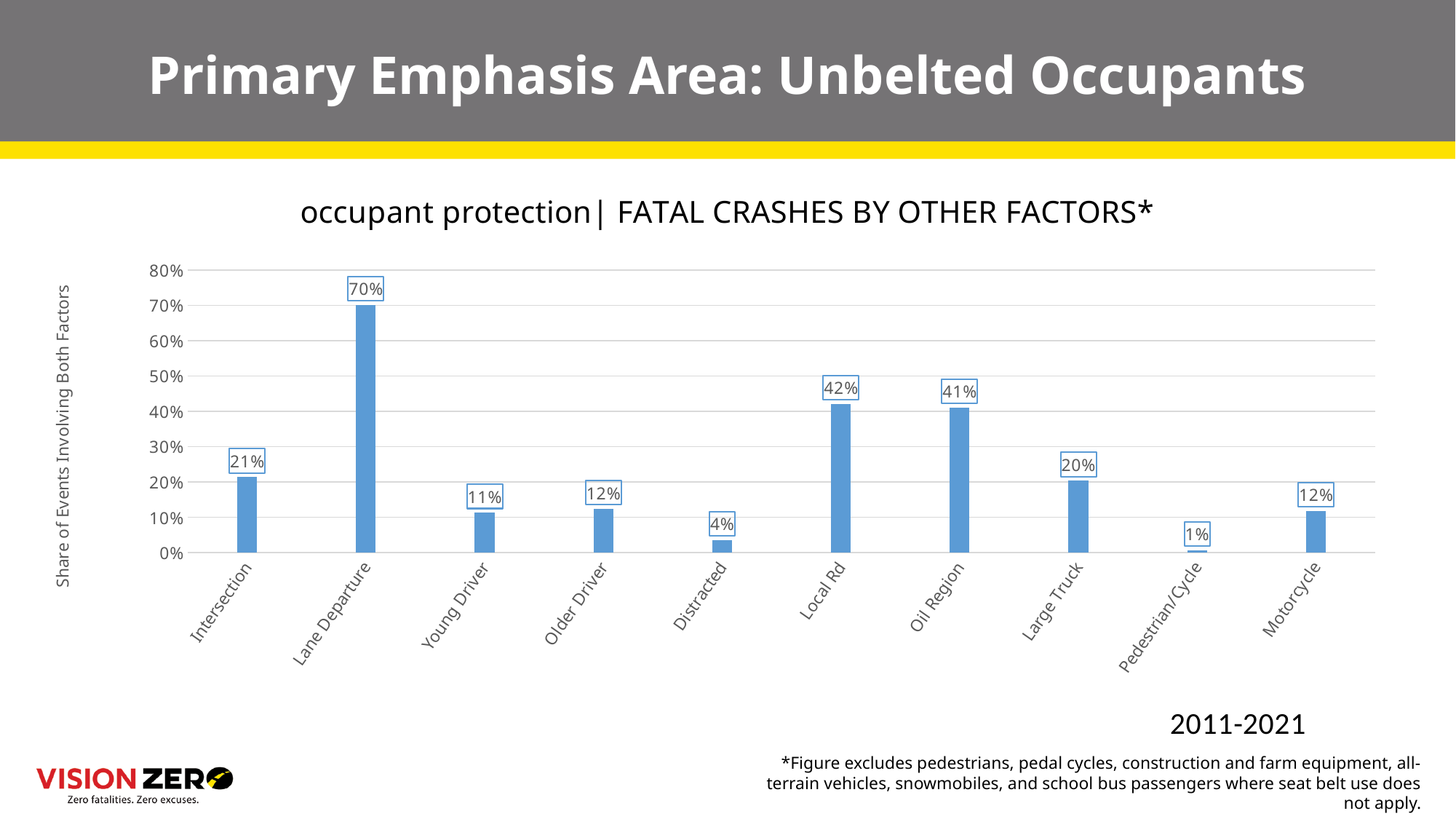
How many categories are shown on the x axis? 10 What is the title of the chart? occupant protection| FATAL CRASHES BY OTHER FACTORS* What is the value for Lane Departure? 70% What is the difference between the values for Lane Departure and Local Rd? 28% What is the value for Local Rd? 42% What is the value for Large Truck? 20% Which is larger, the value for Intersection or the value for Distracted? Intersection Which category has the highest value? Lane Departure Which category has the lowest value? Pedestrian/Cycle What is the label of the y axis? Share of Events Involving Both Factors What is the value for Pedestrian/Cycle? 1% What kind of chart is this? Bar chart